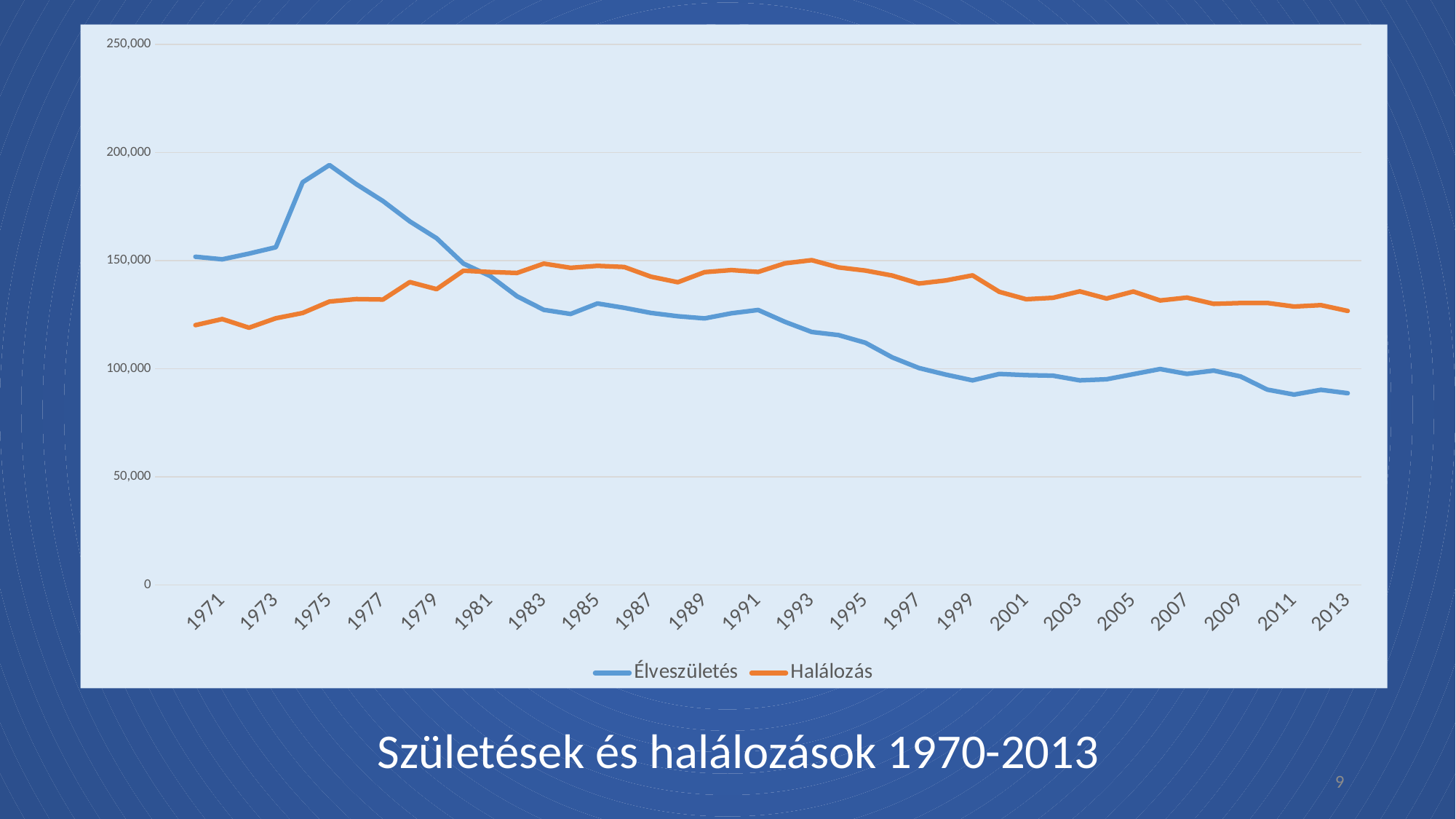
What is the title shown below the chart? Születések és halálozások 1970-2013 What kind of chart is shown on the slide? line chart In which year does the Élveszületés series reach its highest value? 1975 Is the value for Élveszületés in 2013 greater or less than 100,000? less Is the value for Élveszületés in 1975 greater or less than 150,000? greater Is the value for Élveszületés in 1999 greater or less than 100,000? less How many series does the legend list? 2 What are the two series named in the legend? Élveszületés and Halálozás In 2013, which series has the higher value, Élveszületés or Halálozás? Halálozás In 1975, which series has the higher value, Élveszületés or Halálozás? Élveszületés Does the Élveszületés series generally rise or fall from 1975 to 2013? fall